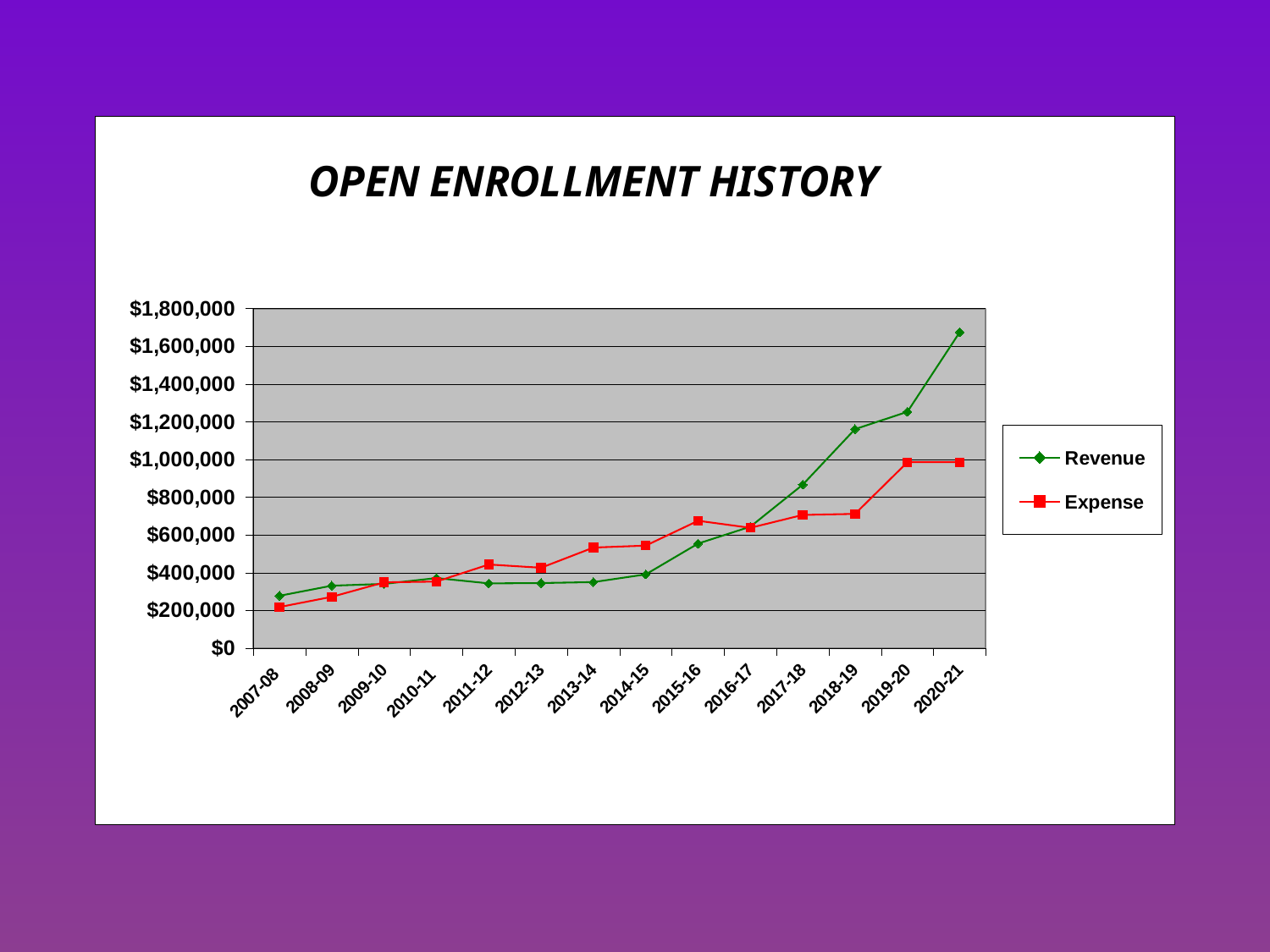
In 2020-21, which is larger, Revenue or Expense? Revenue In 2015-16, which is larger, Revenue or Expense? Expense Is the Revenue value for 2013-14 greater or less than $400,000? less Is the Revenue value for 2020-21 greater or less than $1,600,000? greater What kind of chart is shown on the slide? line chart In which year is Revenue highest? 2020-21 What is the title of the chart? OPEN ENROLLMENT HISTORY In which year is Expense lowest? 2007-08 How many series does the legend list? 2 Is the Expense value for 2017-18 greater or less than $600,000? greater How many school years are plotted along the x axis? 14 Does Revenue generally rise or fall from 2007-08 to 2020-21? rise